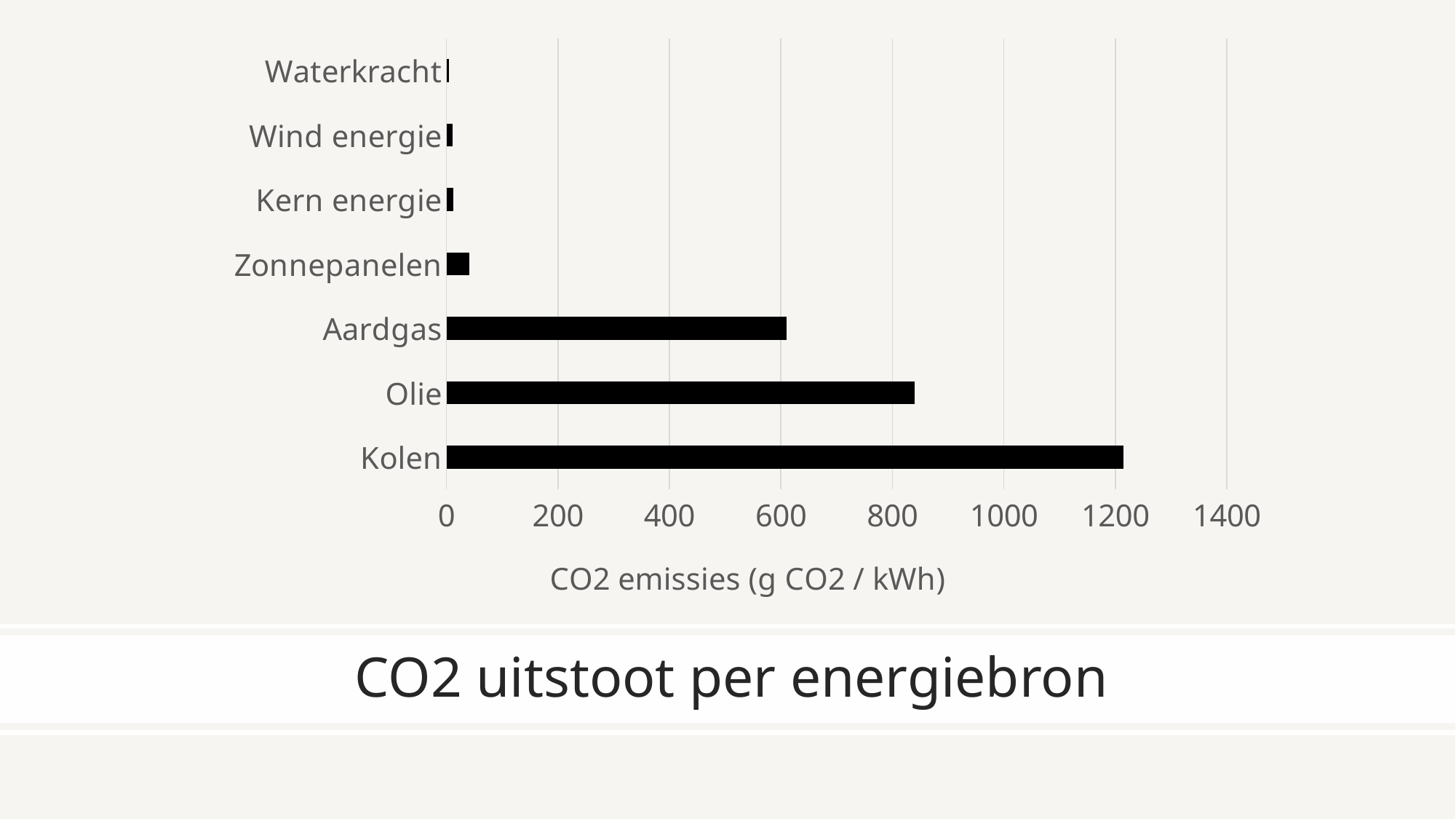
Which has higher CO2 emissions, Zonnepanelen or Kolen? Kolen What is the label of the horizontal axis of the chart? CO2 emissies (g CO2 / kWh) How many energy sources (categories) are shown in the chart? 7 Is the value for Olie greater or less than 1000? less Is the value for Olie greater or less than 800? greater Is the value for Zonnepanelen greater or less than 200? less Which has higher CO2 emissions, Olie or Aardgas? Olie What kind of chart is shown on the slide? bar chart Which energy source has the highest CO2 emissions in the chart? Kolen